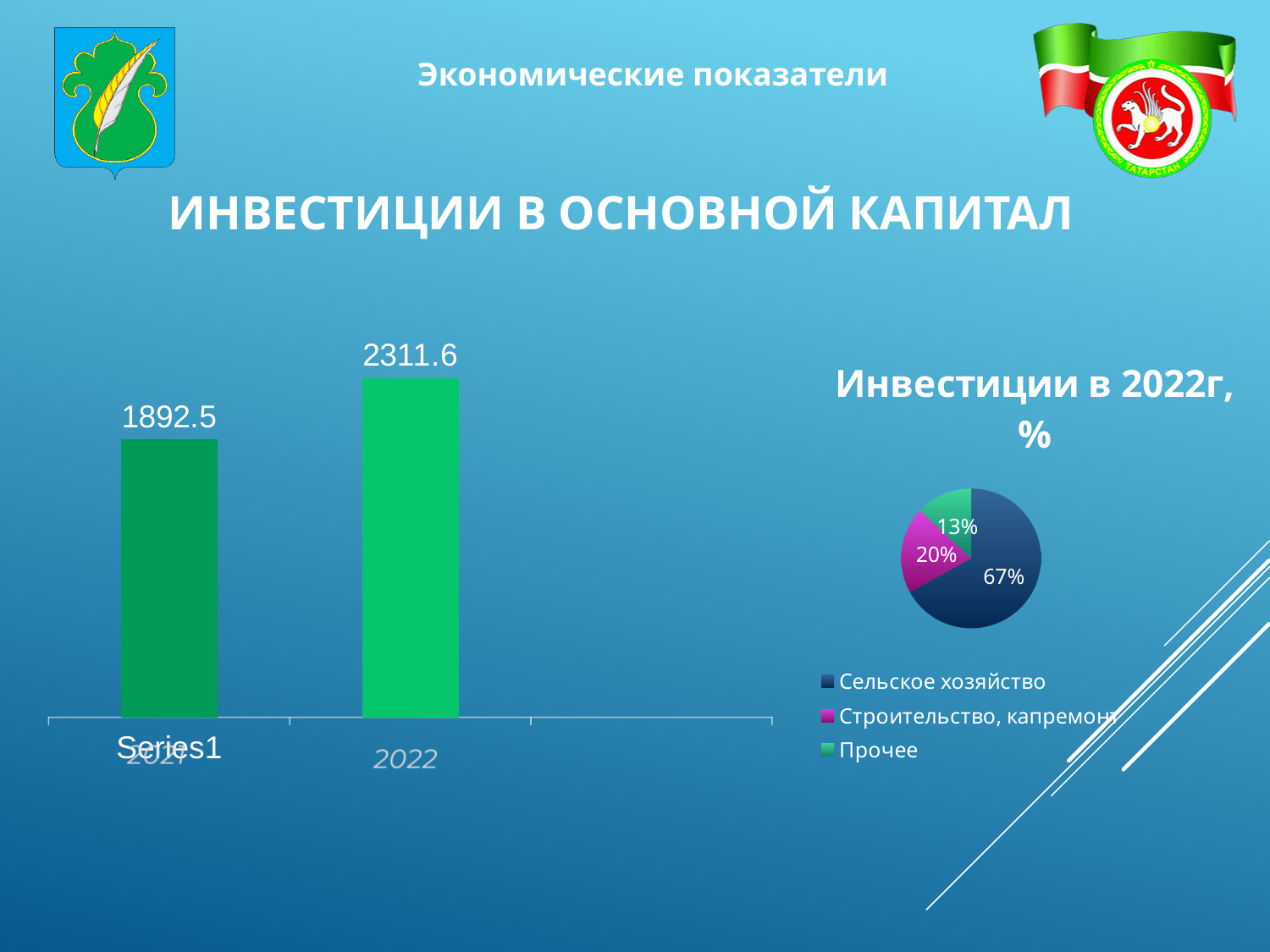
In the pie chart 'Инвестиции в 2022г, %', which category has the smallest share? Прочее In the pie chart 'Инвестиции в 2022г, %', what share does Сельское хозяйство have? 67% How many entries does the legend of the pie chart 'Инвестиции в 2022г, %' list? 3 What kind of chart is the chart on the right? pie chart In the bar chart on the left, do the values rise or fall from 2021 to 2022? rise What kind of chart is the chart on the left? bar chart In the bar chart on the left, which year has the higher value? 2022 How many bars are in the bar chart on the left? 2 In the pie chart 'Инвестиции в 2022г, %', what share does Строительство, капремонт have? 20% In the bar chart on the left, what is the difference between the 2022 and 2021 values? 419.1 In the bar chart on the left, what is the value for 2021? 1892.5 In the bar chart on the left, what is the value for 2022? 2311.6